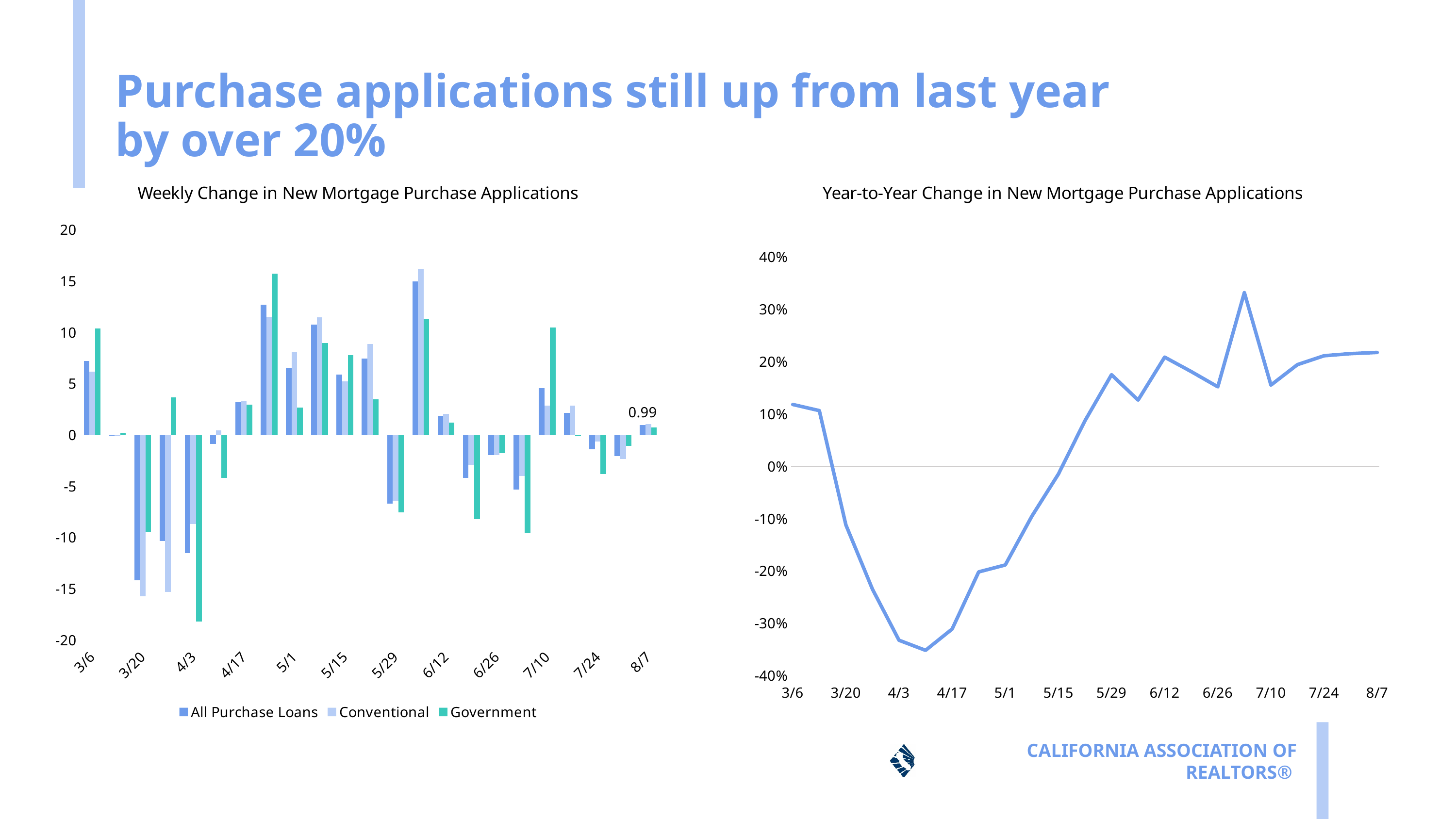
In the 'Weekly Change in New Mortgage Purchase Applications' chart, which series has the highest bar at 3/6? Government How many series does the legend of the 'Weekly Change in New Mortgage Purchase Applications' chart list? 3 In the 'Weekly Change in New Mortgage Purchase Applications' chart, which series has the lowest bar at 4/3? Government What is the only data label printed on the 'Weekly Change in New Mortgage Purchase Applications' chart? 0.99 In the 'Weekly Change in New Mortgage Purchase Applications' chart, is the All Purchase Loans value at 3/20 greater or less than -10? less What are the legend entries of the 'Weekly Change in New Mortgage Purchase Applications' chart? All Purchase Loans, Conventional, Government In the 'Year-to-Year Change in New Mortgage Purchase Applications' chart, does the line rise or fall between 3/6 and 4/3? fall How many date labels are shown on the x axis of the 'Year-to-Year Change in New Mortgage Purchase Applications' chart? 12 What kind of chart is the 'Weekly Change in New Mortgage Purchase Applications' chart? bar chart What kind of chart is the 'Year-to-Year Change in New Mortgage Purchase Applications' chart? line chart In the 'Year-to-Year Change in New Mortgage Purchase Applications' chart, is the value at 4/3 greater or less than -30%? less In the 'Year-to-Year Change in New Mortgage Purchase Applications' chart, is the value at 8/7 greater or less than 20%? greater